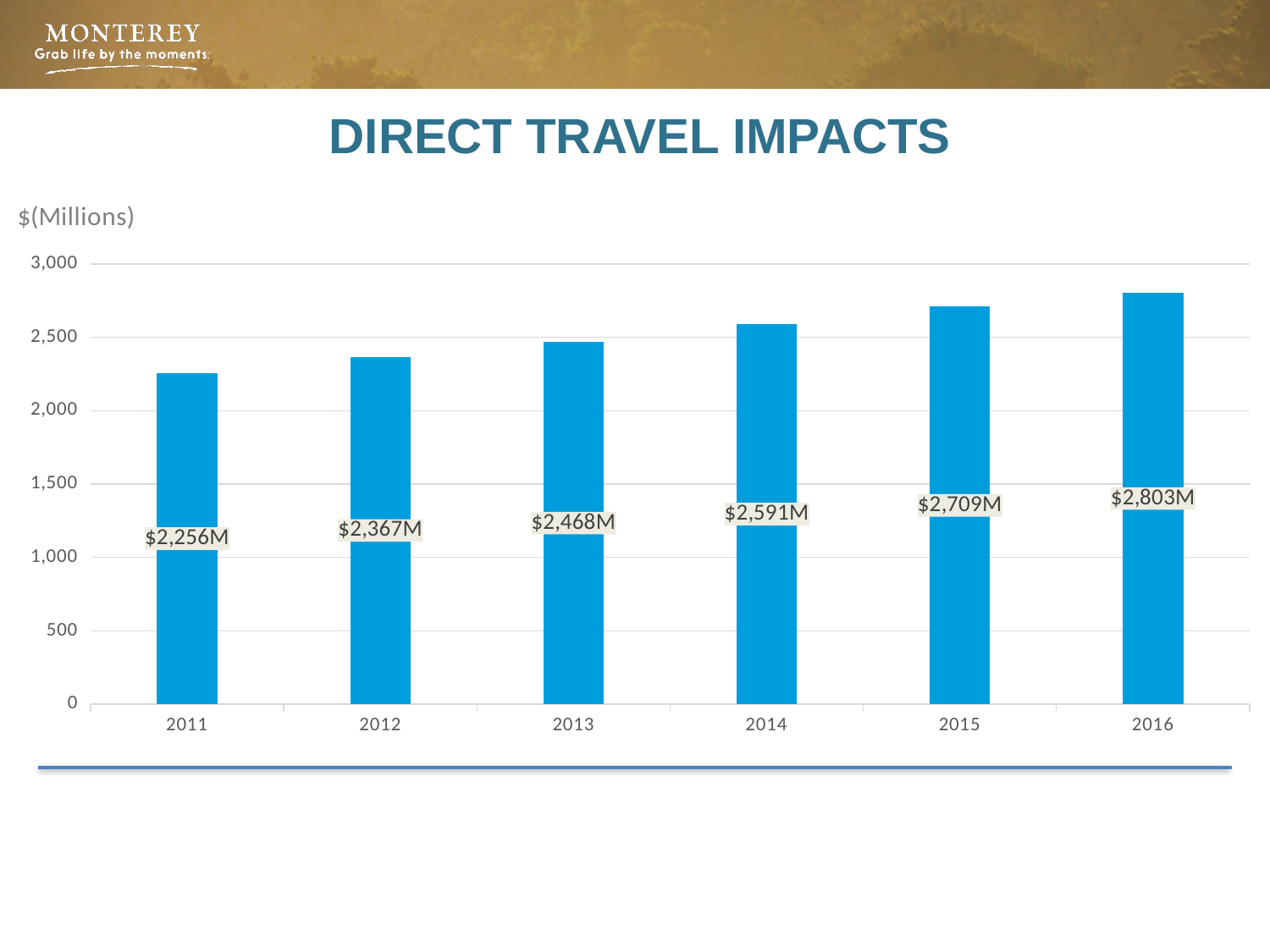
How many years are shown on the chart? 6 What is the direct travel impact value for 2011? $2,256M What kind of chart is shown on the slide? bar chart What is the direct travel impact value for 2014? $2,591M Do the values rise or fall from 2011 to 2016? rise Which year has the lowest direct travel impact? 2011 What is the difference between the 2016 and 2011 values? $547M Which is larger, the value for 2015 or the value for 2013? 2015 What is the direct travel impact value for 2016? $2,803M What is the difference between the 2013 and 2012 values? $101M Is the value for 2014 greater or less than 2,500? greater Which year has the highest direct travel impact? 2016